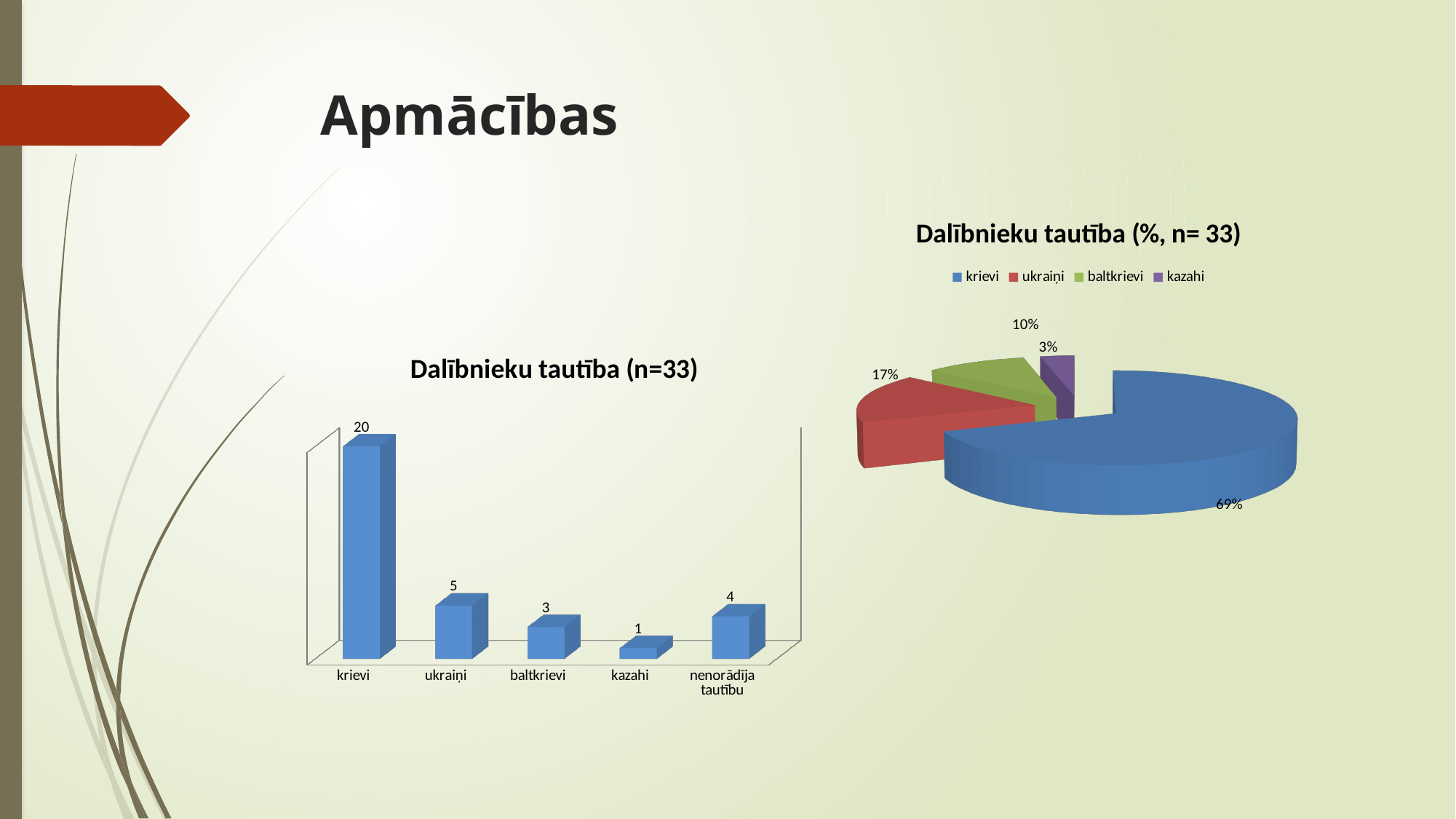
In the bar chart 'Dalībnieku tautība (n=33)', what is the value for ukraiņi? 5 In the bar chart 'Dalībnieku tautība (n=33)', which category has the lowest value? kazahi What kind of chart is 'Dalībnieku tautība (n=33)' on the left of the slide? bar chart In the pie chart 'Dalībnieku tautība (%, n= 33)', what share does ukraiņi have? 17% In the bar chart 'Dalībnieku tautība (n=33)', what is the value for nenorādīja tautību? 4 In the bar chart 'Dalībnieku tautība (n=33)', what is the difference between the values for krievi and ukraiņi? 15 How many categories are shown in the bar chart 'Dalībnieku tautība (n=33)'? 5 In the bar chart 'Dalībnieku tautība (n=33)', which category has the highest value? krievi In the bar chart 'Dalībnieku tautība (n=33)', what is the value for krievi? 20 How many entries does the legend of the pie chart 'Dalībnieku tautība (%, n= 33)' list? 4 In the pie chart 'Dalībnieku tautība (%, n= 33)', what share does krievi have? 69% In the bar chart 'Dalībnieku tautība (n=33)', which is larger, the value for baltkrievi or the value for nenorādīja tautību? nenorādīja tautību